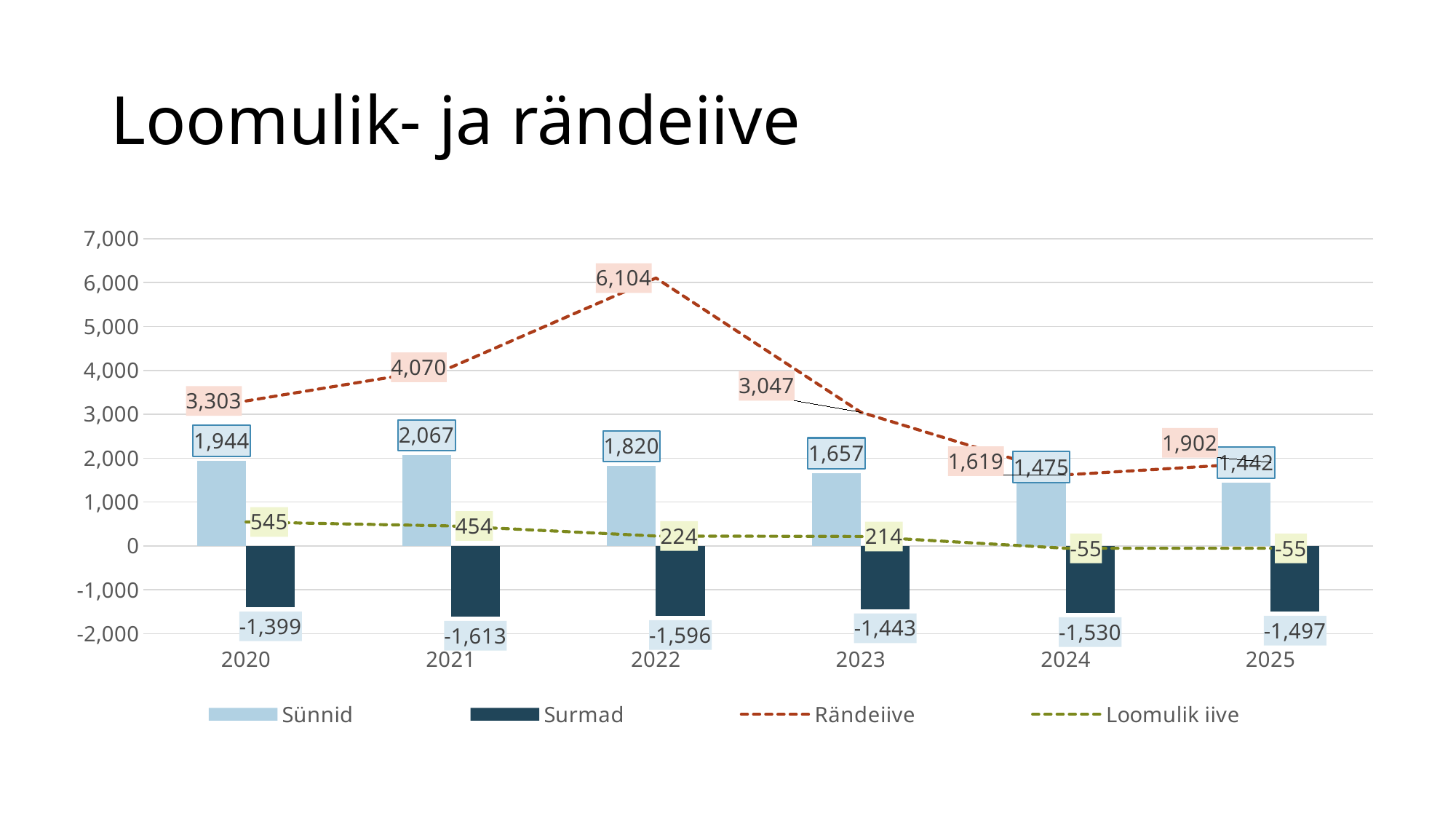
In which year is Sünnid lowest? 2025 How many years are shown on the x axis? 6 What is the value of Rändeiive for 2022? 6,104 What is the value of Loomulik iive for 2023? 214 Which is larger, Sünnid in 2020 or Sünnid in 2022? Sünnid in 2020 What is the value of Sünnid for 2021? 2,067 What kind of chart is this? Combined bar and line chart Does Sünnid rise or fall from 2021 to 2025? Fall What is the difference between Rändeiive in 2022 and in 2023? 3,057 What is the value of Surmad for 2024? -1,530 How many series does the legend list? 4 In which year is Rändeiive highest? 2022